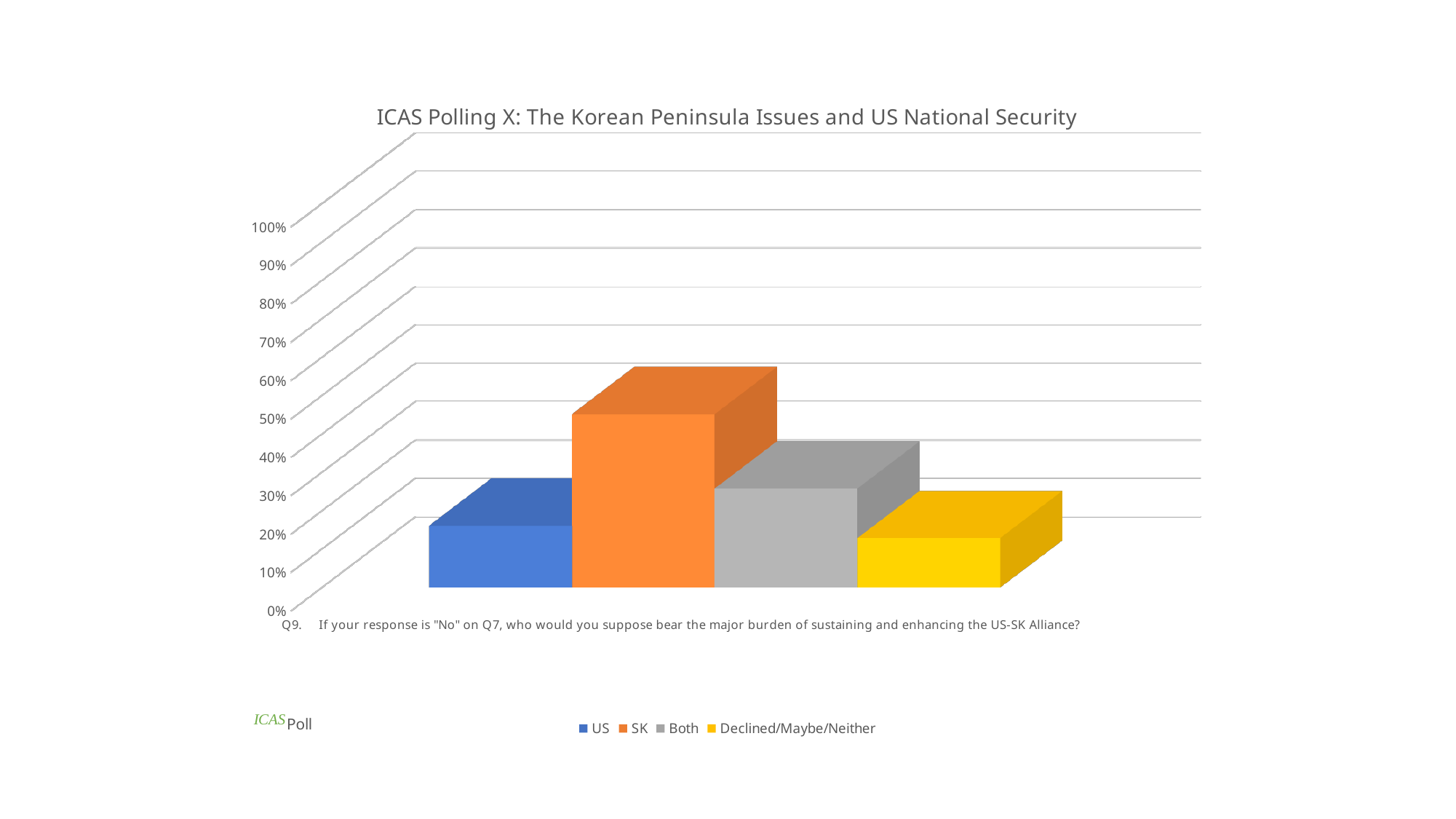
Which is larger, the value for US or the value for Both? Both Which response has the highest value in the chart? SK What kind of chart is shown on the slide? bar chart Which series is shown in orange in the legend? SK How many series does the legend list? 4 How many bars are plotted in the chart? 4 What is the title of the chart? ICAS Polling X: The Korean Peninsula Issues and US National Security Is the value for US greater or less than 30%? less Is the value for SK greater or less than 30%? greater Which is larger, the value for SK or the value for Both? SK Which response has the lowest value in the chart? Declined/Maybe/Neither